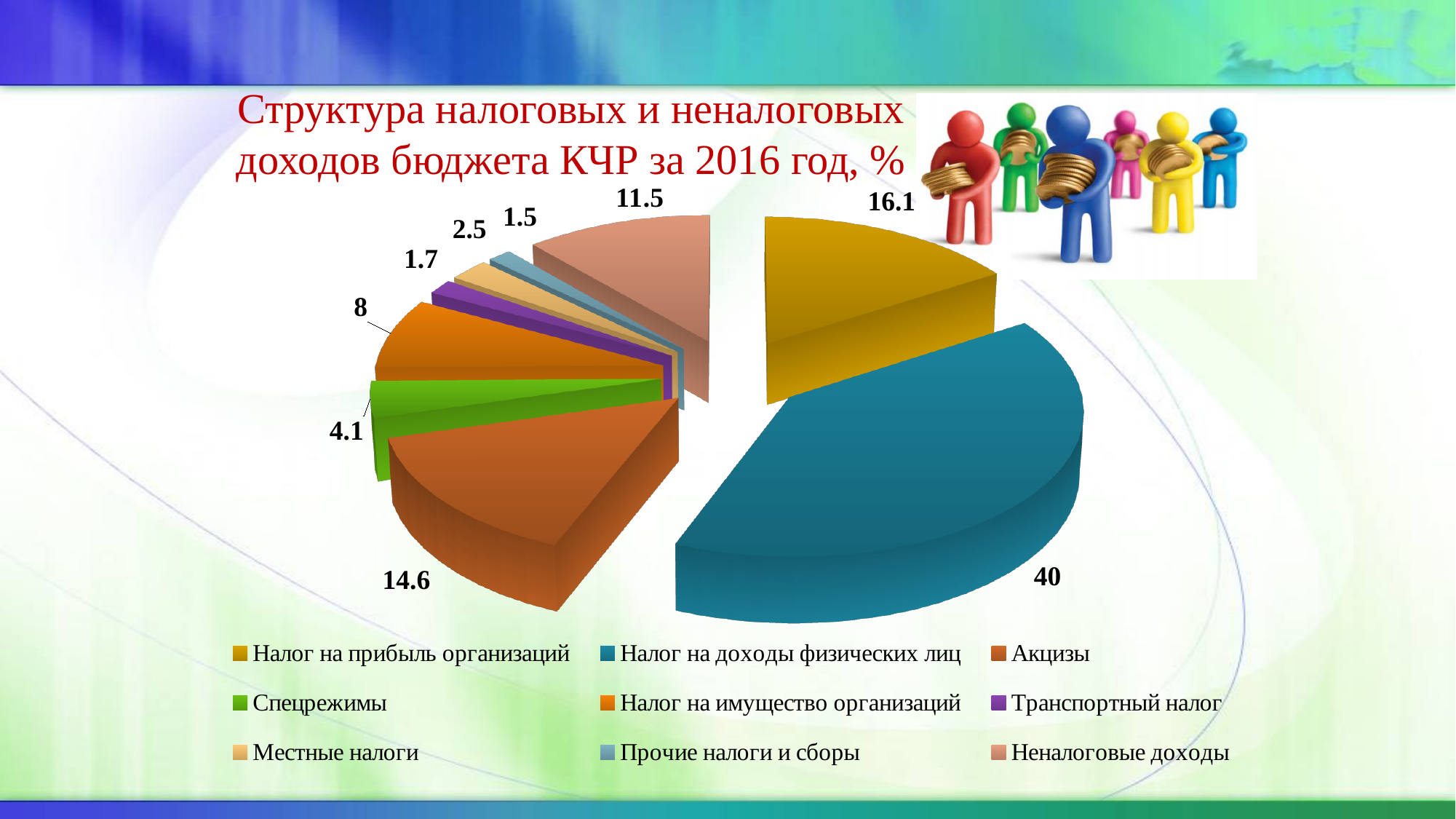
What is the value for Акцизы? 14.6 What kind of chart is shown on the slide? pie chart How many categories does the legend list? 9 What is the title of the chart? Структура налоговых и неналоговых доходов бюджета КЧР за 2016 год, % What is the value for Налог на прибыль организаций? 16.1 Which category has the largest share of the pie? Налог на доходы физических лиц Which is larger, Спецрежимы or Налог на имущество организаций? Налог на имущество организаций What is the value for Налог на доходы физических лиц? 40 What is the value for Транспортный налог? 1.7 What is the difference between the values for Налог на прибыль организаций and Акцизы? 1.5 What is the value for Неналоговые доходы? 11.5 Which category has the smallest share of the pie? Прочие налоги и сборы